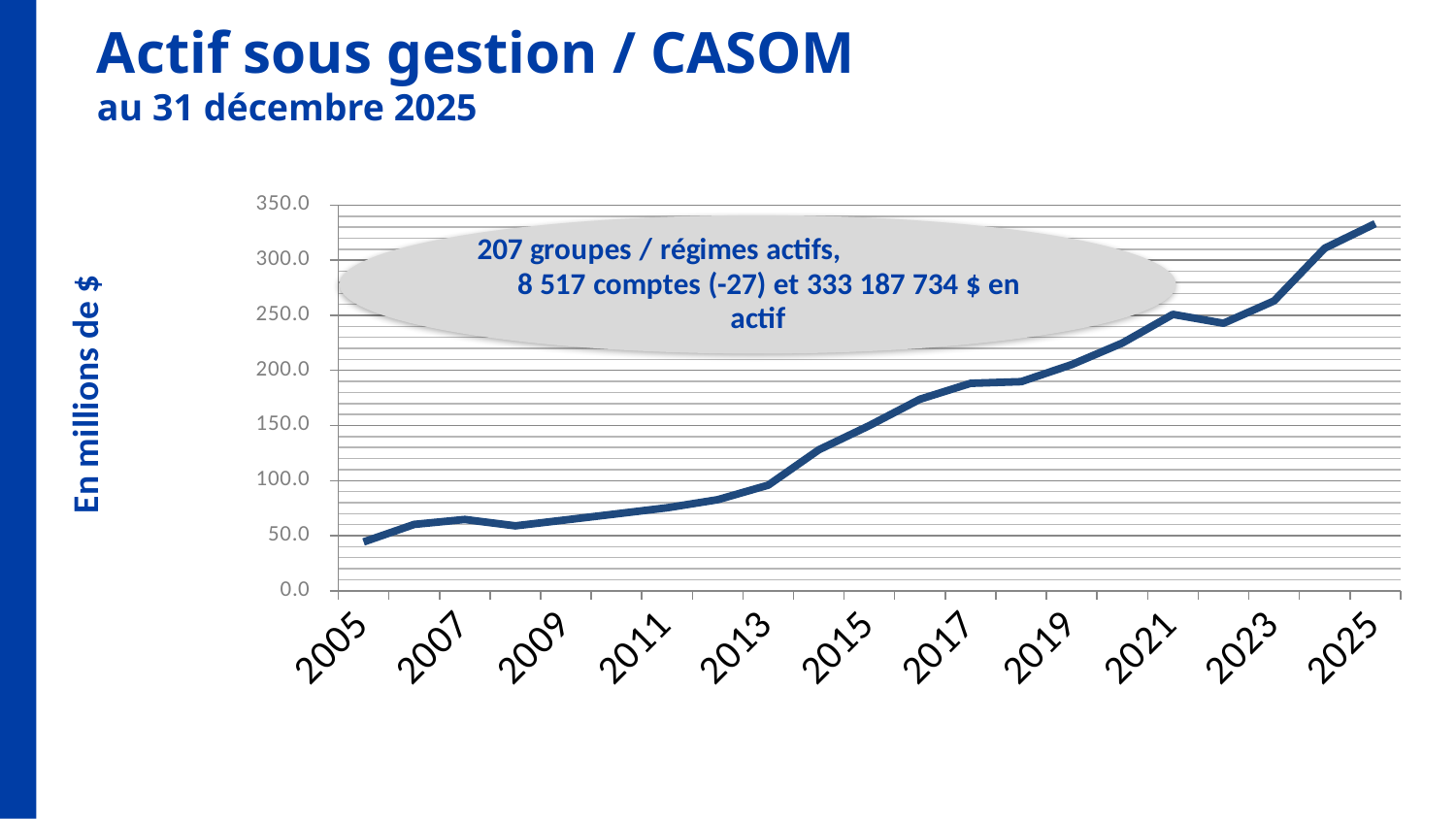
What is the label on the vertical axis of the chart? En millions de $ Which year has the highest value on the chart? 2025 Is the value for 2005 greater or less than 50? less How many year labels are shown on the x axis? 11 Do the values generally rise or fall from 2005 to 2025? rise Is the value for 2017 greater or less than 150? greater Is the value for 2025 greater or less than 300? greater What kind of chart is shown on the slide? line chart Which year has the lowest value on the chart? 2005 Which is larger, the value for 2015 or the value for 2011? 2015